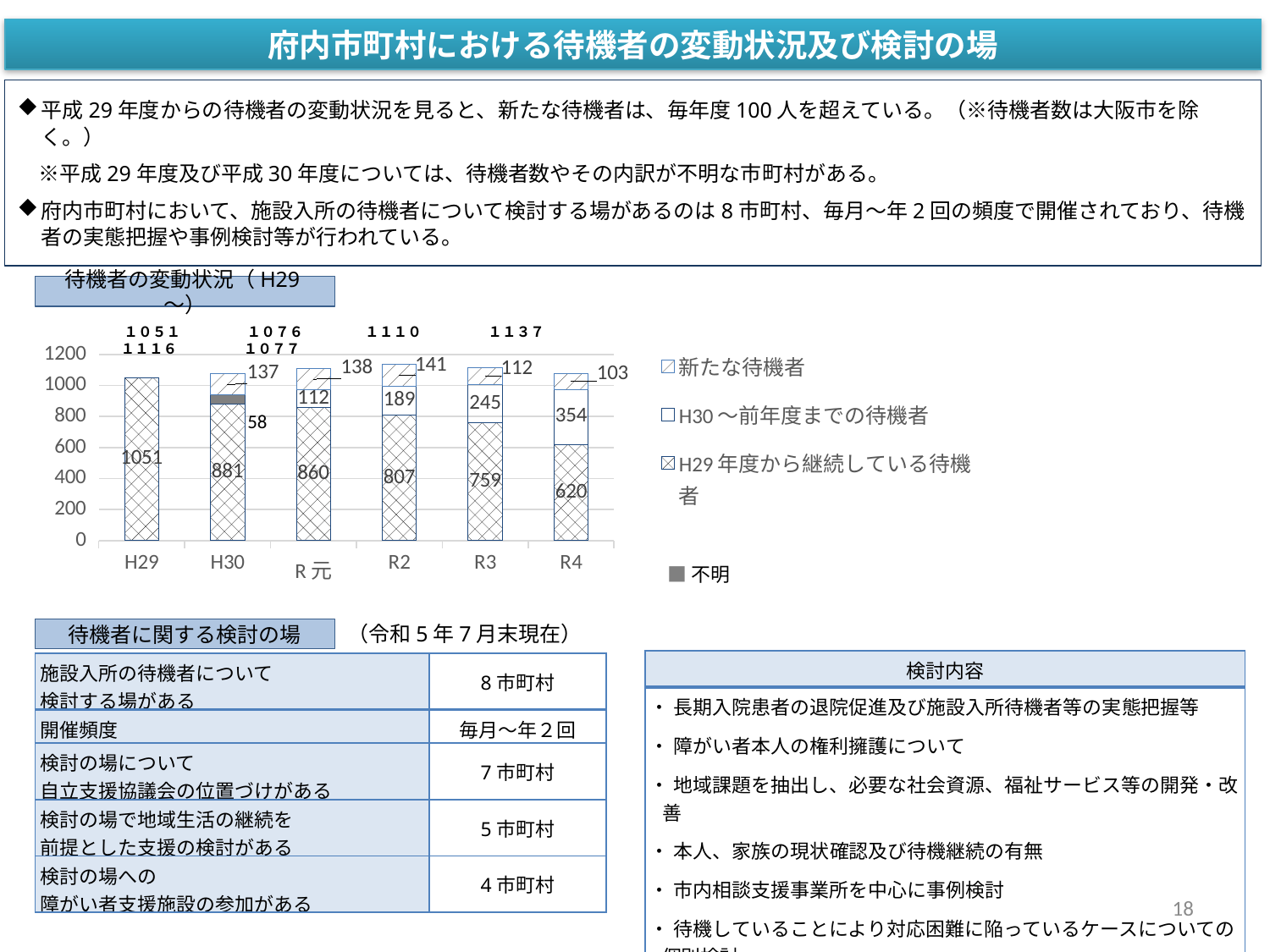
What kind of chart is used in the 待機者の変動状況（H29～） chart? stacked bar chart In the 待機者の変動状況（H29～） chart, does the value of H29年度から継続している待機者 rise or fall from H29 to R4? fall In the 待機者の変動状況（H29～） chart, how many categories are shown on the x axis? 6 In the 待機者の変動状況（H29～） chart, what is the value of H30～前年度までの待機者 for R3? 245 In the 待機者の変動状況（H29～） chart, what is the difference between the 新たな待機者 values for R2 and R4? 38 In the 待機者の変動状況（H29～） chart, how many series does the legend list? 4 In the 待機者の変動状況（H29～） chart, what is the value of 新たな待機者 for R2? 141 In the 待機者の変動状況（H29～） chart, what is the value of H29年度から継続している待機者 for R4? 620 In the 待機者の変動状況（H29～） chart, what is the total of the stacked bar for R2? 1137 In the 待機者の変動状況（H29～） chart, which category has the lowest value of 新たな待機者 among H30 to R4? R4 In the 待機者の変動状況（H29～） chart, which category has the highest value of H29年度から継続している待機者? H29